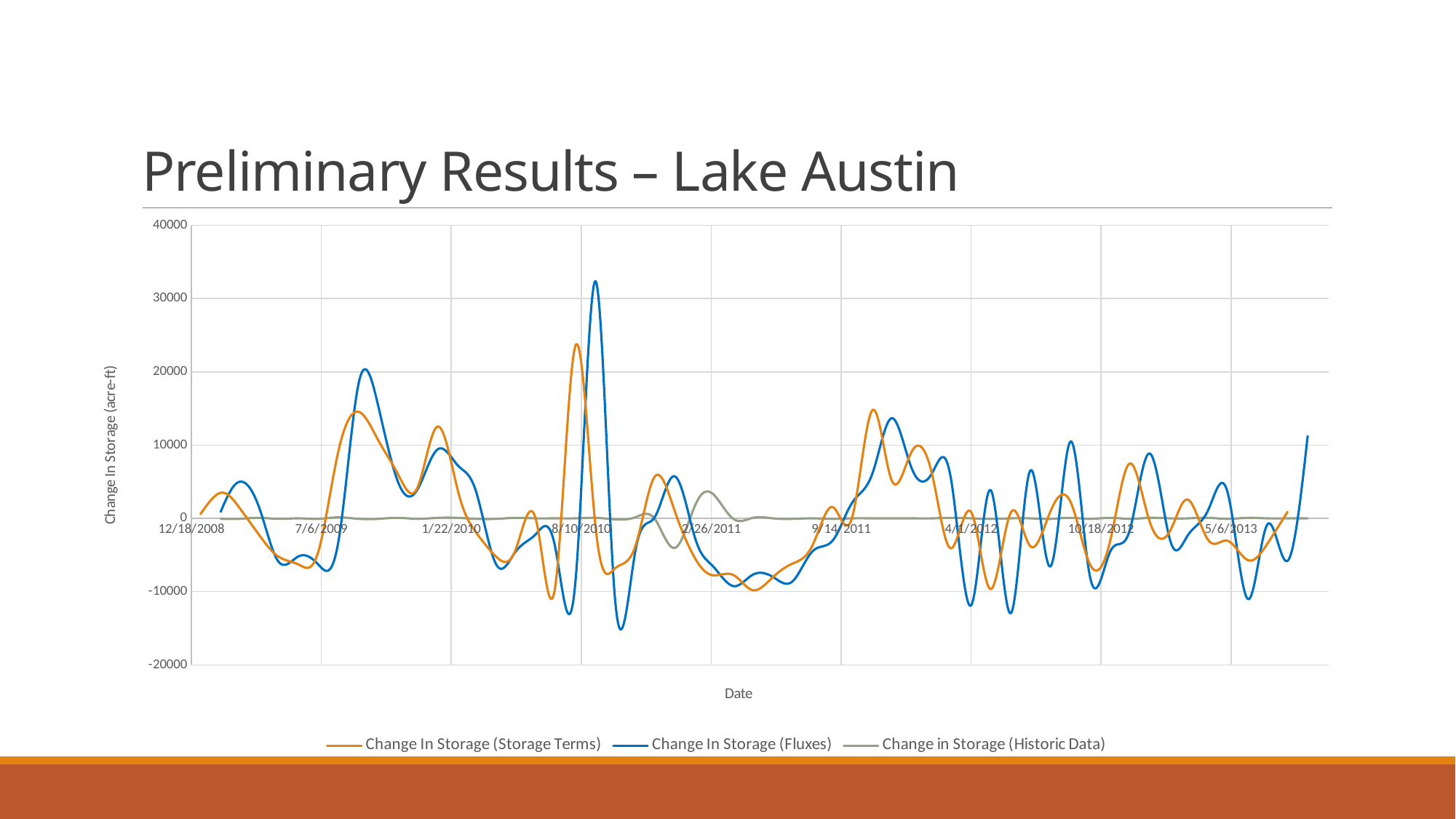
Is the highest peak of the Change In Storage (Fluxes) series greater or less than 30000? greater Which series reaches the highest peak on the chart? Change In Storage (Fluxes) Is the highest peak of the Change In Storage (Storage Terms) series greater or less than 20000? greater How many series does the legend list? 3 Which series stays closest to zero across the whole date range? Change in Storage (Historic Data) Is the lowest point of the Change In Storage (Fluxes) series greater or less than -10000? less Which is larger: the highest peak of Change In Storage (Fluxes) or the highest peak of Change In Storage (Storage Terms)? Change In Storage (Fluxes) What is the label on the vertical axis of the chart? Change In Storage (acre-ft) How many date labels are shown on the x axis? 9 What is the title of the slide containing the chart? Preliminary Results – Lake Austin What kind of chart is shown on the slide? line chart